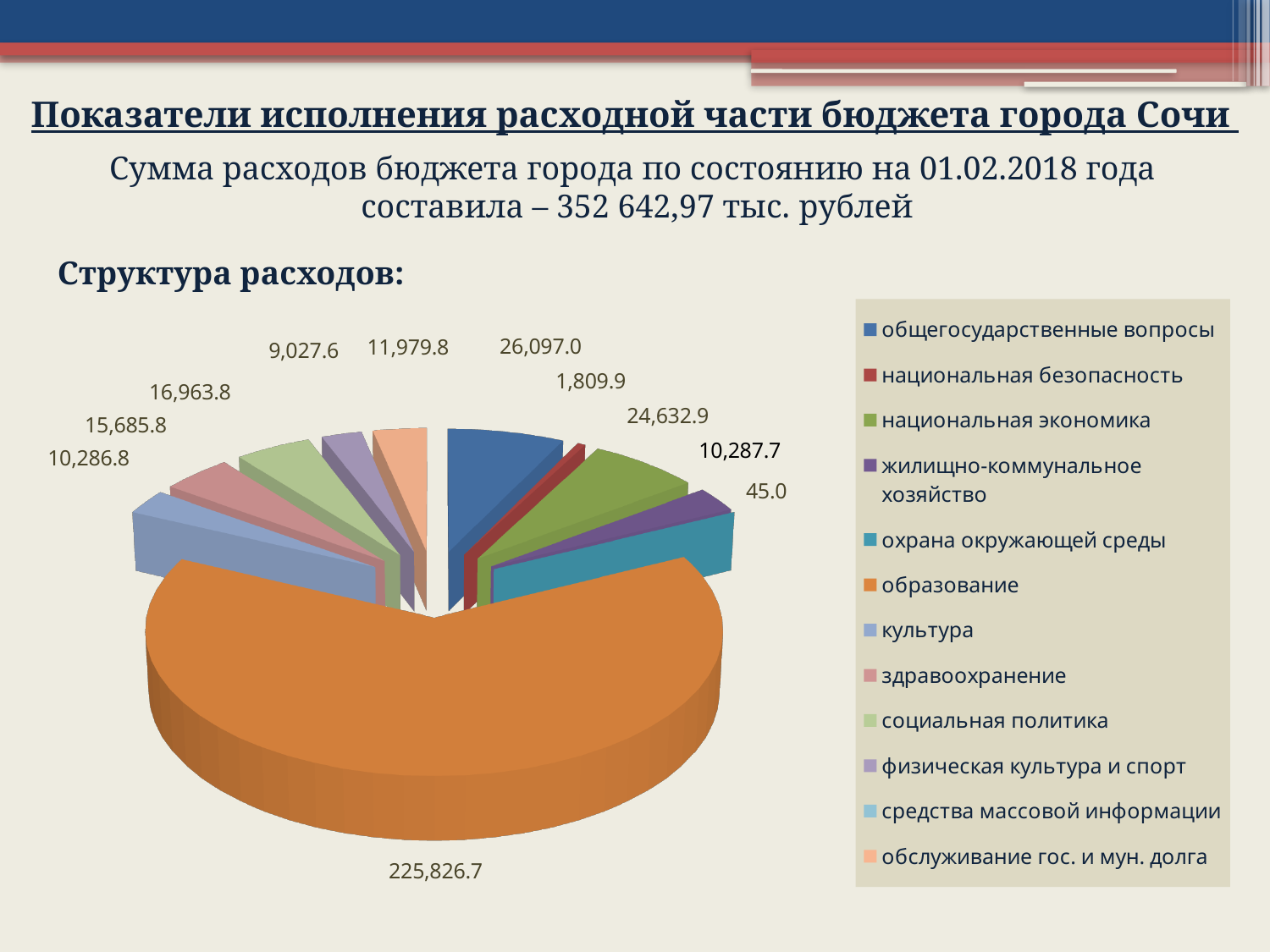
What kind of chart is shown on the slide? pie chart What is the difference between the value for образование and the value for общегосударственные вопросы? 199,729.7 Which is larger, the value for общегосударственные вопросы or the value for национальная экономика? общегосударственные вопросы What is the value shown for социальная политика? 16,963.8 Which category has the largest slice in the pie chart? образование What is the value shown for образование? 225,826.7 What is the value shown for общегосударственные вопросы? 26,097.0 What is the value shown for национальная экономика? 24,632.9 What is the value shown for здравоохранение? 15,685.8 How many categories does the legend of the pie chart list? 12 What is the smallest data label shown on the pie chart? 45.0 What is the value shown for национальная безопасность? 1,809.9